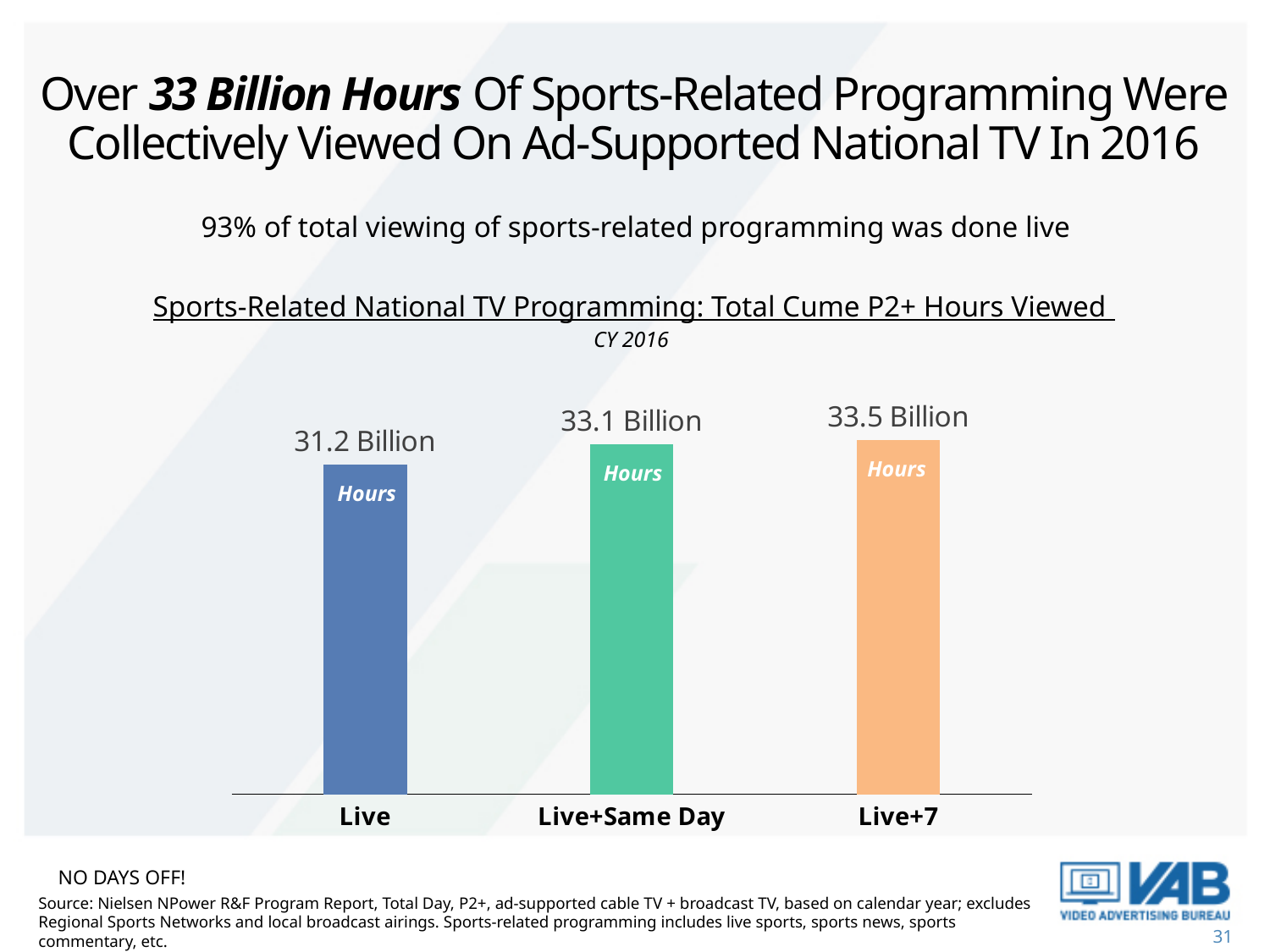
Do the values rise or fall from Live to Live+7? Rise What is the difference between the values for Live+Same Day and Live? 1.9 Billion What kind of chart is shown on the slide? Bar chart What is the difference between the values for Live+7 and Live? 2.3 Billion What is the value for Live? 31.2 Billion What is the value for Live+7? 33.5 Billion What is the title of the chart? Sports-Related National TV Programming: Total Cume P2+ Hours Viewed Which is larger, the value for Live or the value for Live+Same Day? Live+Same Day What is the value for Live+Same Day? 33.1 Billion Which category has the highest value? Live+7 Which category has the lowest value? Live How many categories are shown in the chart? 3